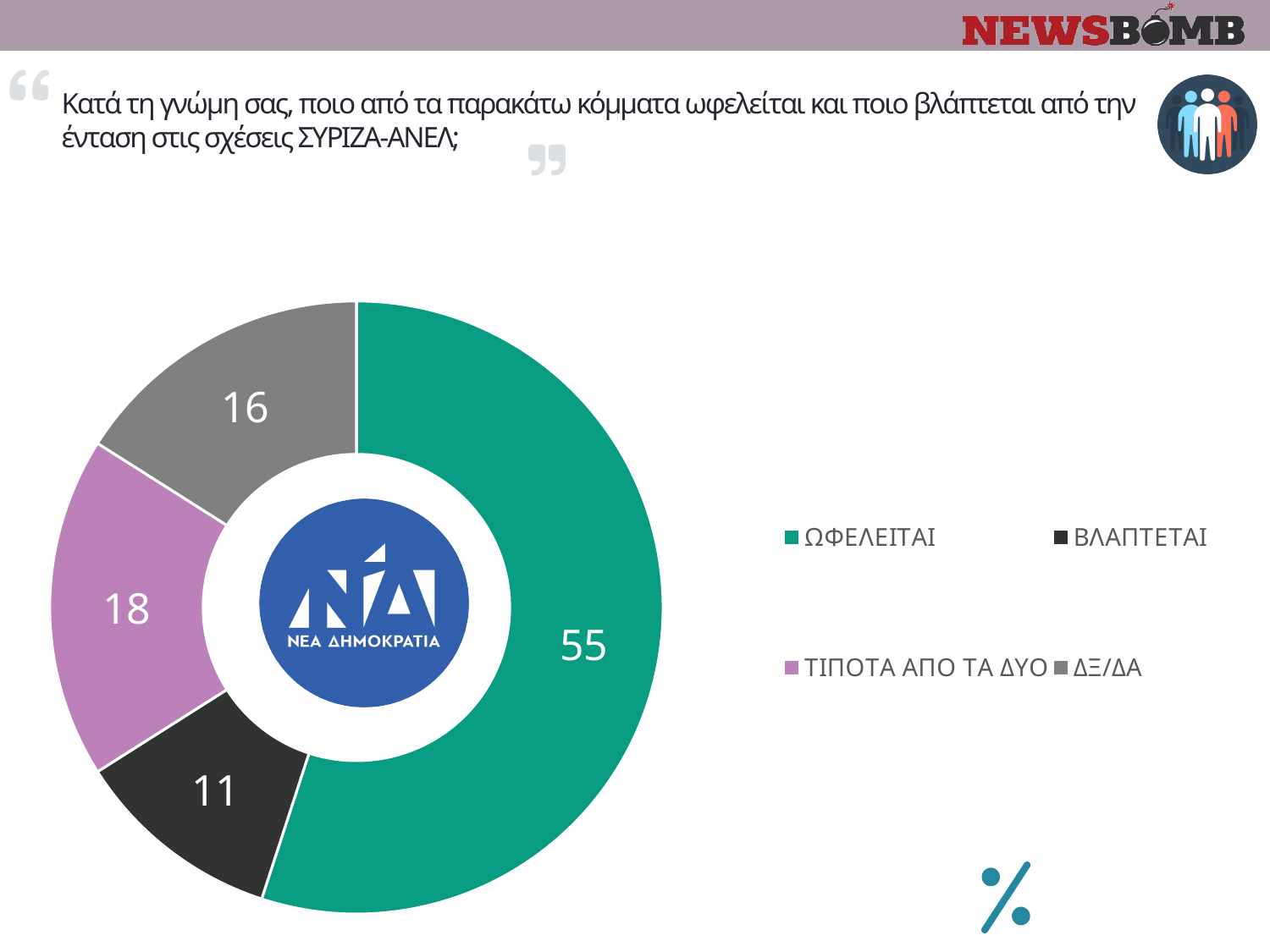
What value is shown for ΩΦΕΛΕΙΤΑΙ in the doughnut chart? 55 What value is shown for ΤΙΠΟΤΑ ΑΠΟ ΤΑ ΔΥΟ in the doughnut chart? 18 Which category has the largest slice in the doughnut chart? ΩΦΕΛΕΙΤΑΙ What colour is the ΩΦΕΛΕΙΤΑΙ slice in the doughnut chart? Green What kind of chart is shown on the slide? Doughnut chart What is the difference between the values for ΤΙΠΟΤΑ ΑΠΟ ΤΑ ΔΥΟ and ΔΞ/ΔΑ? 2 What value is shown for ΒΛΑΠΤΕΤΑΙ in the doughnut chart? 11 How many categories does the doughnut chart show? 4 Which is larger, the value for ΤΙΠΟΤΑ ΑΠΟ ΤΑ ΔΥΟ or the value for ΔΞ/ΔΑ? ΤΙΠΟΤΑ ΑΠΟ ΤΑ ΔΥΟ Which category has the smallest slice in the doughnut chart? ΒΛΑΠΤΕΤΑΙ What is the difference between the values for ΩΦΕΛΕΙΤΑΙ and ΒΛΑΠΤΕΤΑΙ? 44 What value is shown for ΔΞ/ΔΑ in the doughnut chart? 16